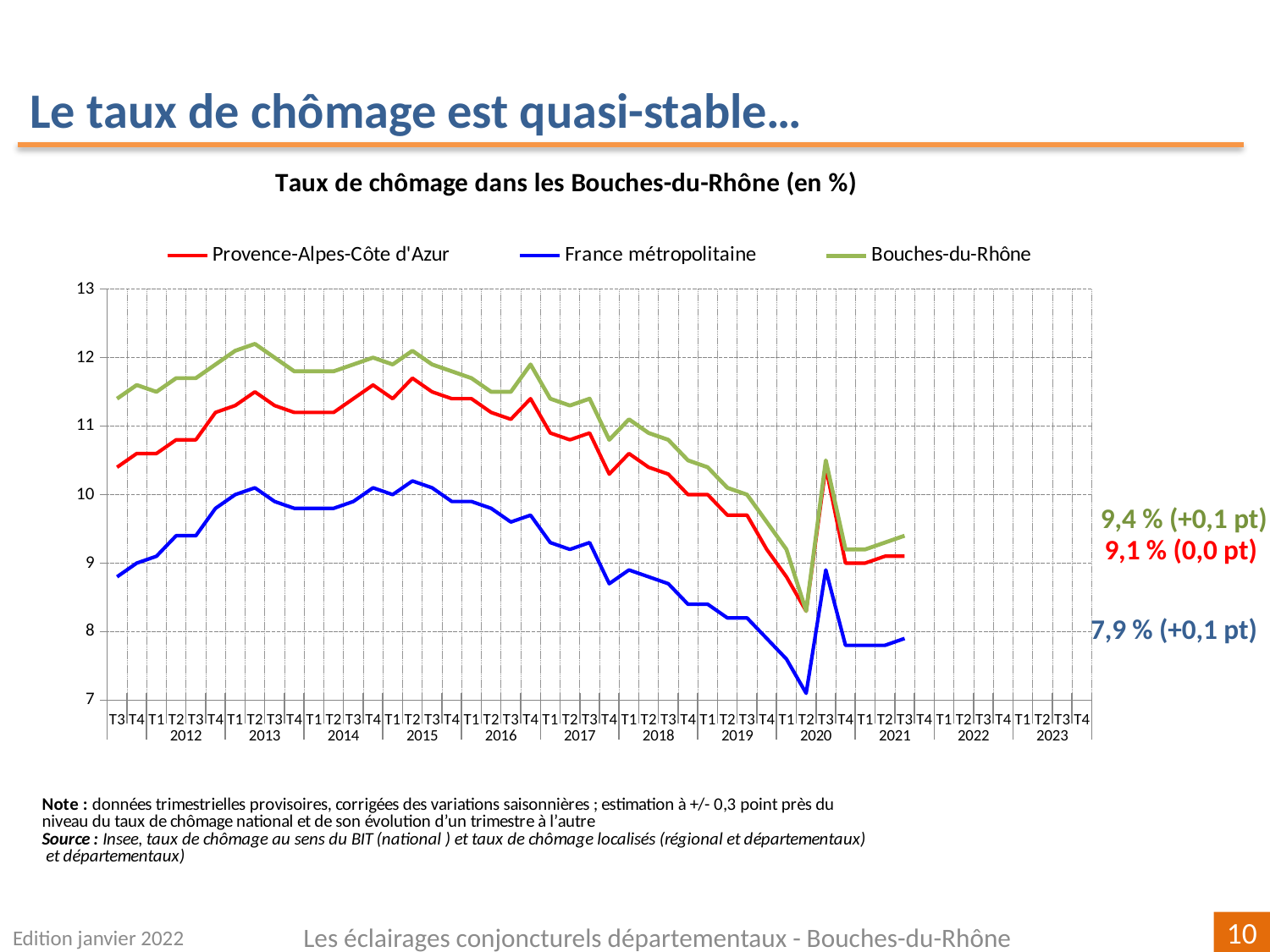
What kind of chart is shown on the slide? Line chart What quarterly change is annotated for the Bouches-du-Rhône series at its latest point? +0,1 pt How many series does the legend list? 3 What is the latest unemployment rate shown for Provence-Alpes-Côte d'Azur? 9,1 % Which series is plotted in blue? France métropolitaine What is the latest unemployment rate shown for Bouches-du-Rhône? 9,4 % What is the latest unemployment rate shown for France métropolitaine? 7,9 % What is the difference between the latest rates for Bouches-du-Rhône and France métropolitaine? 1,5 points At the latest point, which is higher: Bouches-du-Rhône or France métropolitaine? Bouches-du-Rhône Is the value for Bouches-du-Rhône in T2 2013 greater or less than 12? greater Is the value for France métropolitaine in T2 2020 greater or less than 8? less Between 2013 and 2019, does the Bouches-du-Rhône unemployment rate generally rise or fall? Fall